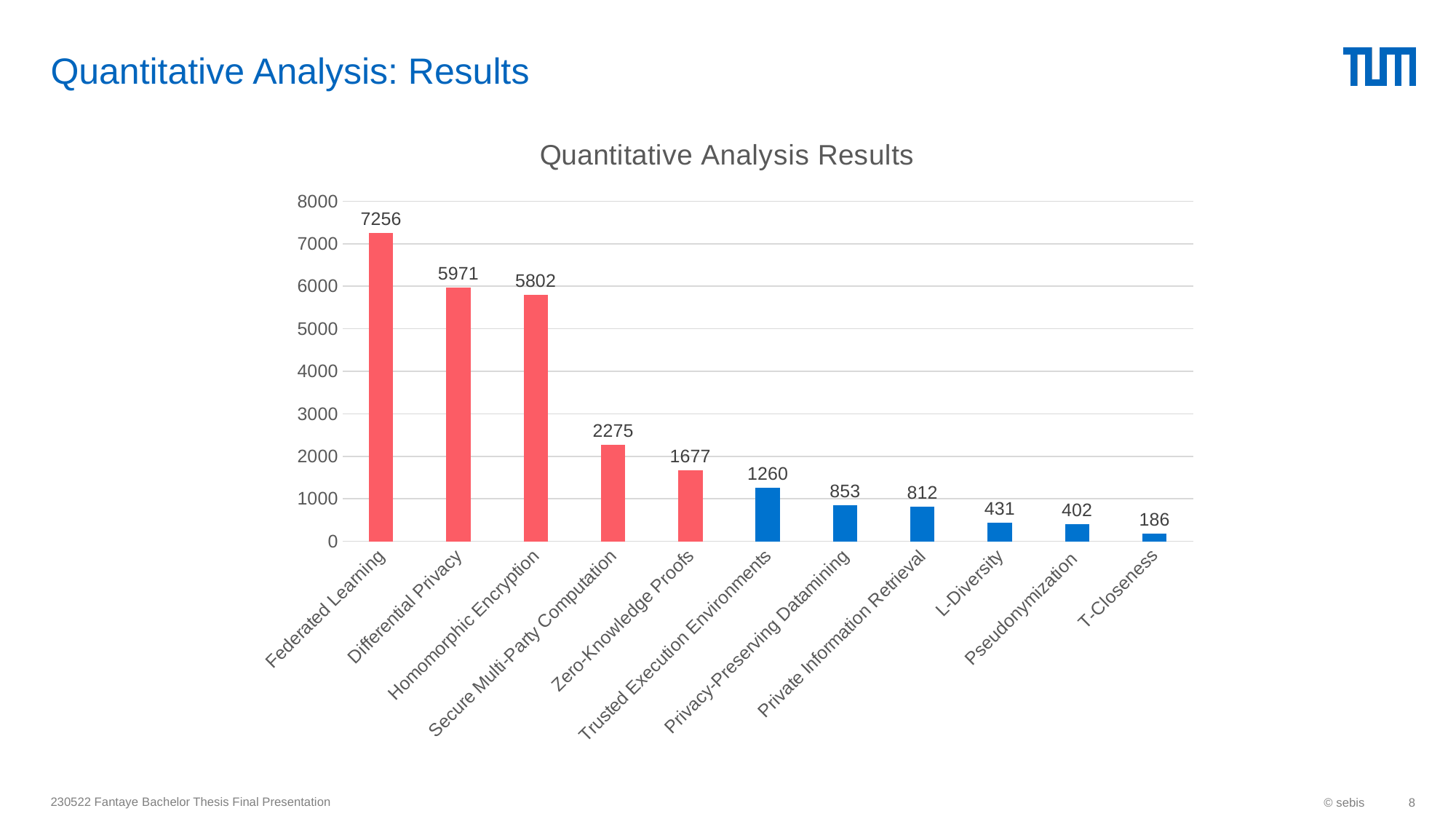
Do the values rise or fall from left to right along the x axis? fall What is the value for Federated Learning? 7256 Which category has the highest value? Federated Learning What is the value for Pseudonymization? 402 Which is larger, the value for Zero-Knowledge Proofs or the value for Trusted Execution Environments? Zero-Knowledge Proofs What is the title of the chart? Quantitative Analysis Results What is the difference between the values for Differential Privacy and Homomorphic Encryption? 169 Is the value for Privacy-Preserving Datamining greater or less than 1000? less What kind of chart is shown on the slide? bar chart What is the value for Secure Multi-Party Computation? 2275 Which category has the lowest value? T-Closeness How many categories are shown on the x axis? 11